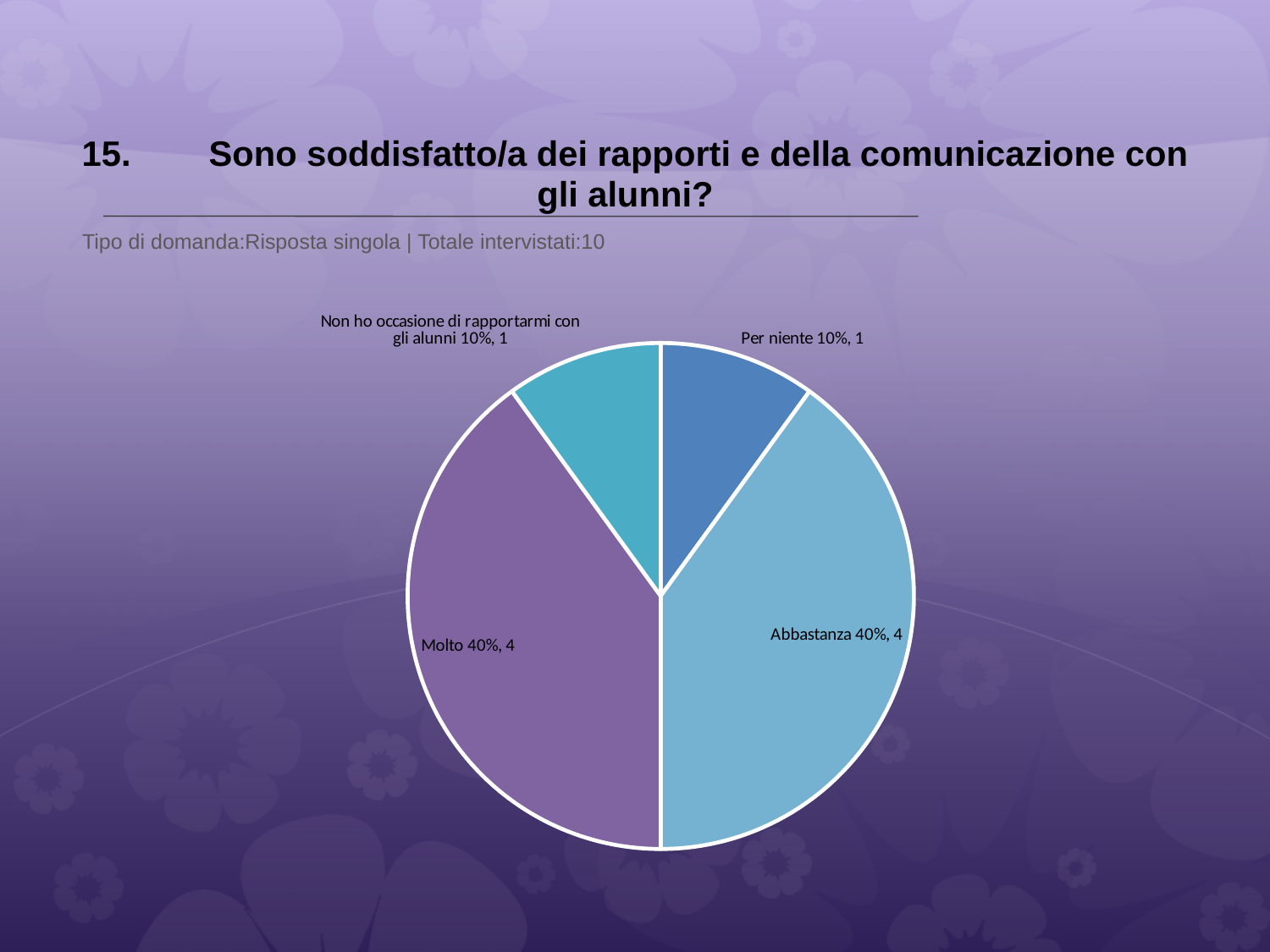
How many slices does the pie chart have? 4 What kind of chart is shown on the slide? Pie chart Which slice is larger, "Abbastanza" or "Per niente"? Abbastanza What is the difference in number of respondents between "Molto" and "Per niente"? 3 How many respondents answered "Molto"? 4 What is the question number shown in the slide title? 15 What share of the pie does the "Molto" slice represent? 40% What is the difference in percentage points between "Abbastanza" and "Non ho occasione di rapportarmi con gli alunni"? 30 What is the total number of respondents shown across all slices of the pie chart? 10 What percentage of respondents answered "Abbastanza"? 40% How many respondents answered "Non ho occasione di rapportarmi con gli alunni"? 1 What percentage of respondents answered "Per niente"? 10%